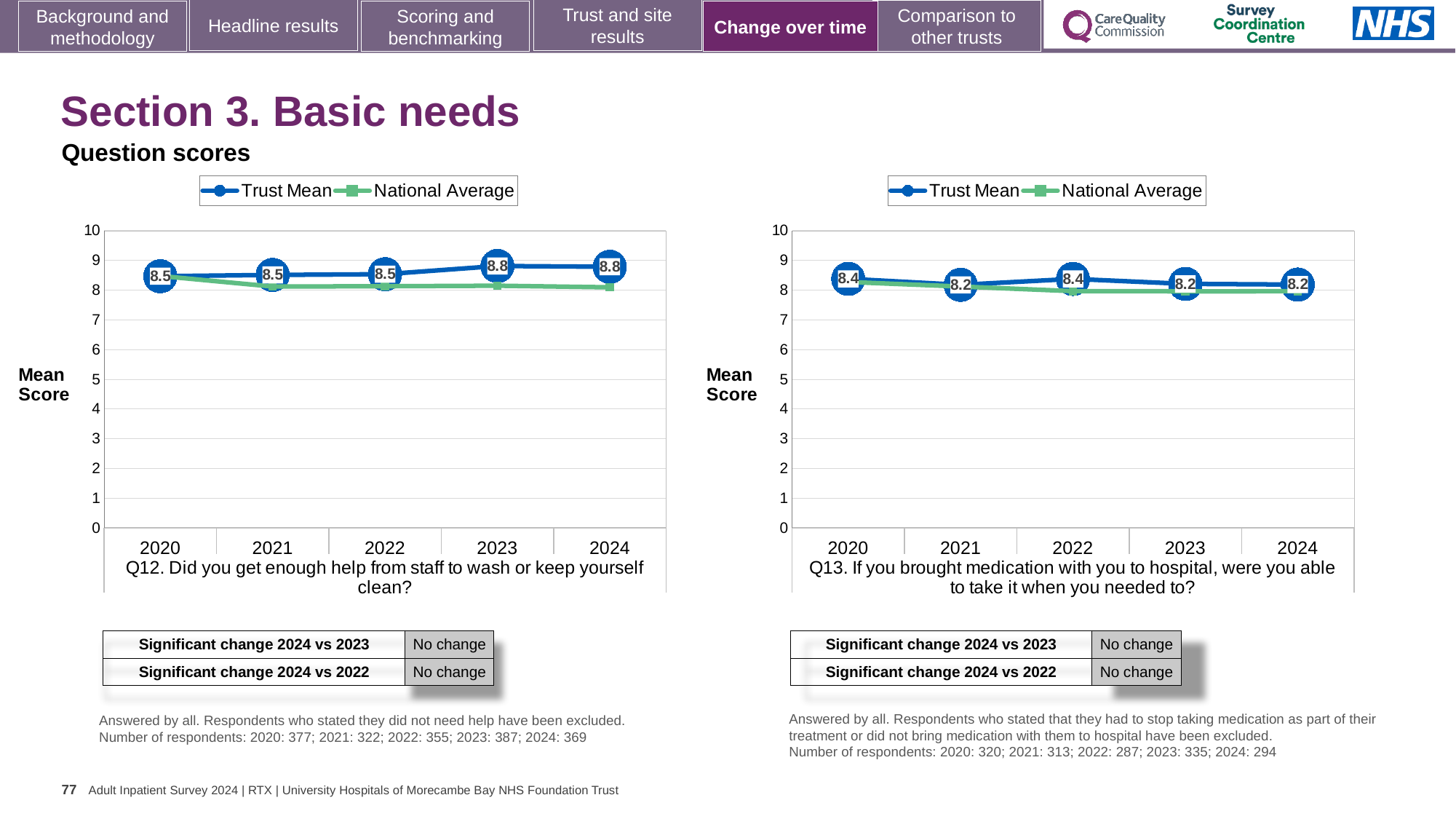
In the Q12 chart (left), what is the Trust Mean for 2020? 8.5 In the Q13 chart (right), what is the difference between the Trust Mean in 2020 and in 2021? 0.2 In the Q13 chart (right), what is the Trust Mean for 2024? 8.2 In the Q13 chart (right), is the National Average for 2024 greater or less than 9? less How many series does the legend of the Q13 chart (right) list? 2 In the Q12 chart (left), which series is shown in green? National Average In the Q13 chart (right), what is the Trust Mean for 2022? 8.4 In the Q12 chart (left), is the Trust Mean for 2023 greater or less than 8? greater In the Q12 chart (left), what is the difference between the Trust Mean in 2024 and in 2022? 0.3 What type of chart is the Q12 chart (left)? Line chart How many years are plotted on the x axis of the Q12 chart (left)? 5 In the Q12 chart (left), what is the Trust Mean for 2024? 8.8